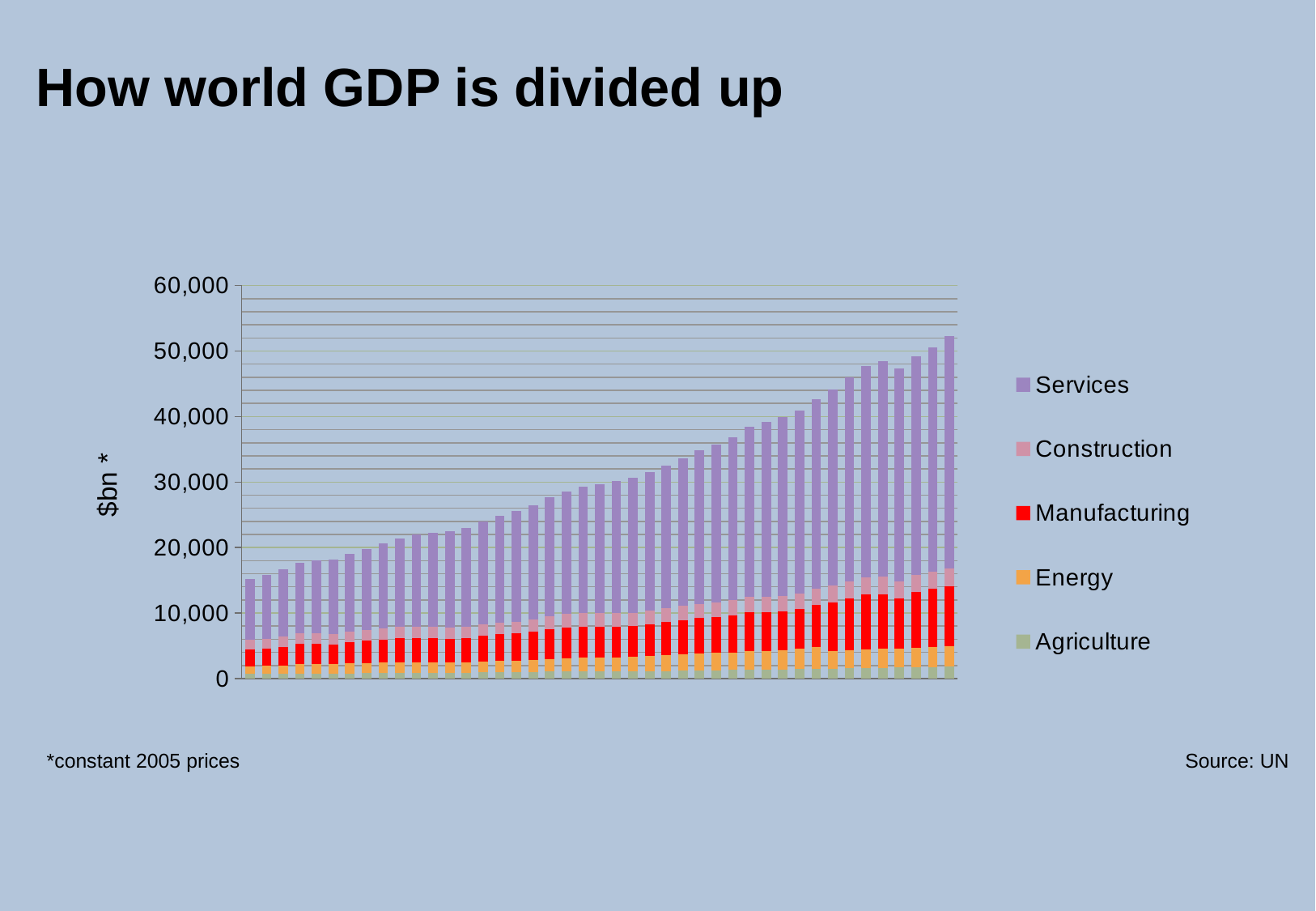
Which series makes up the largest part of each bar? Services Do the total bar heights rise or fall from left to right along the x axis? Rise Is the Manufacturing segment of the rightmost bar greater or less than 20,000? less What is the highest value shown on the vertical axis? 60,000 Which series makes up the smallest part of each bar? Agriculture Is the Services segment larger than the Manufacturing segment in the rightmost bar? Yes Is the total of the leftmost bar greater or less than 20,000? less What is the label on the vertical axis? $bn * What kind of chart is shown on the slide? Stacked bar chart Is the total of the rightmost bar greater or less than 50,000? greater How many series does the legend list? 5 What is the title of the chart on the slide? How world GDP is divided up